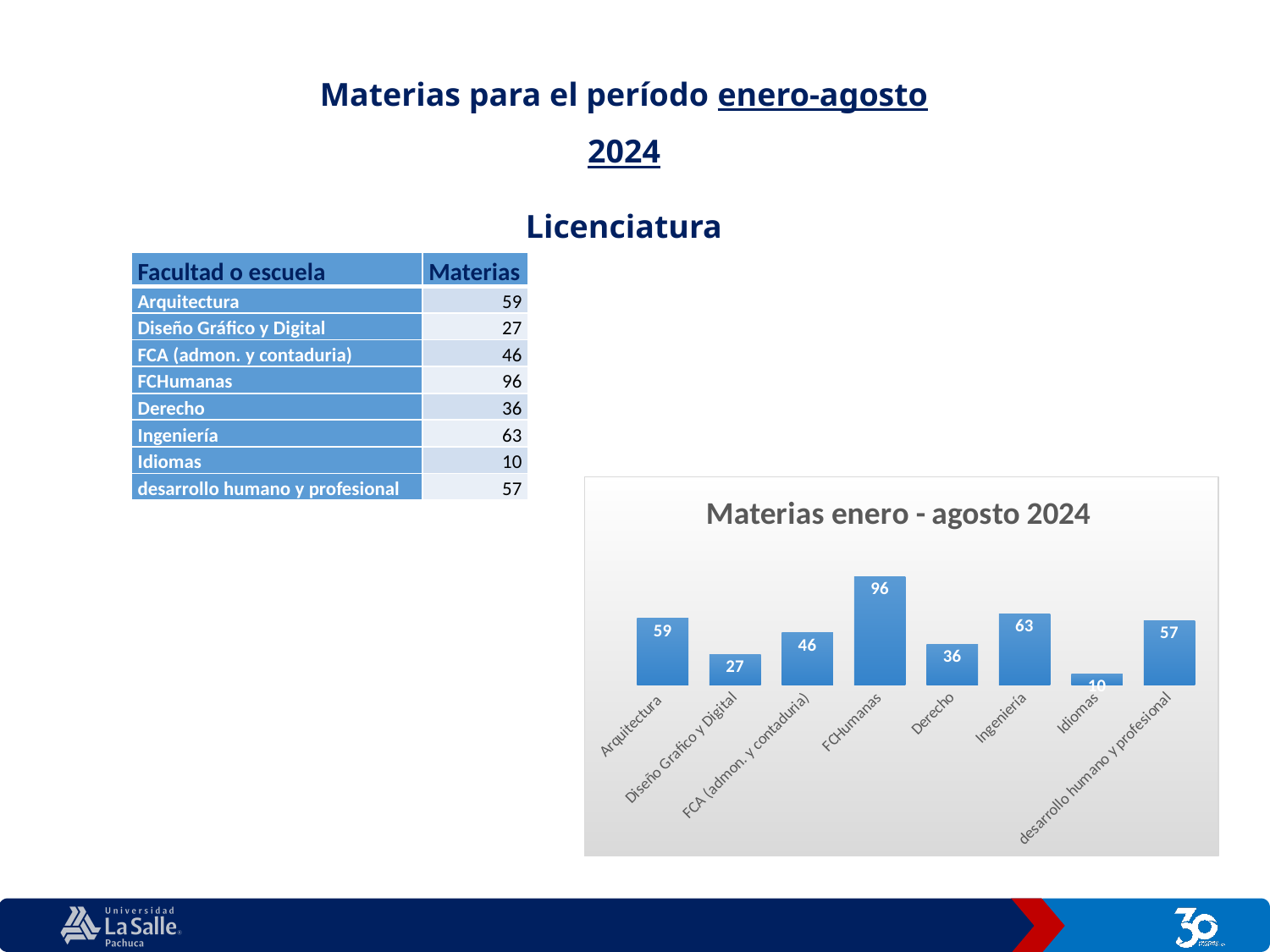
How many categories are shown in the chart? 8 What is the title of the chart? Materias enero - agosto 2024 What is the value for Diseño Gráfico y Digital in the chart? 27 Which is larger, the value for Arquitectura or the value for desarrollo humano y profesional? Arquitectura Which is larger, the value for FCA (admon. y contaduria) or the value for Derecho? FCA (admon. y contaduria) What kind of chart is shown on the slide? Bar chart Which category has the lowest value in the chart? Idiomas What is the difference between the values for FCHumanas and Idiomas? 86 What is the difference between the values for Ingeniería and Arquitectura? 4 Which category has the highest value in the chart? FCHumanas What is the value for Derecho in the chart? 36 What is the value for FCHumanas in the chart? 96